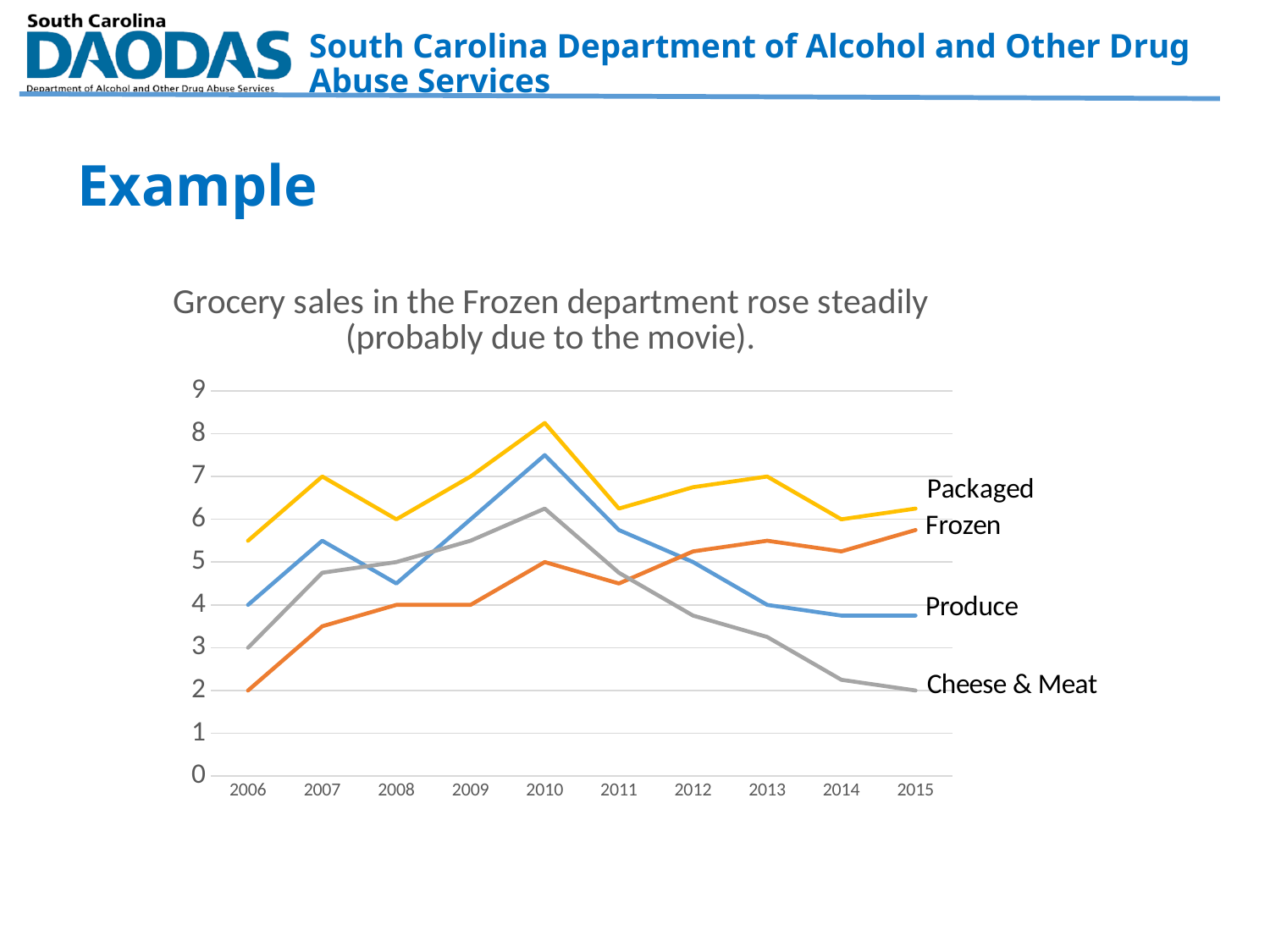
Is the value for Cheese & Meat in 2014 greater or less than 3? less What kind of chart is shown on the slide? line chart Which series has the lowest value in 2015? Cheese & Meat Which series is labelled with the orange line? Frozen In 2015, which is larger, the value for Packaged or the value for Produce? Packaged How many years are shown along the x axis? 10 How many series are plotted on the chart? 4 Does the Cheese & Meat line rise or fall from 2010 to 2015? fall Which series has the highest value in 2010? Packaged Which series has the lowest value in 2006? Frozen Is the value for Packaged in 2010 greater or less than 8? greater What is the title of the chart? Grocery sales in the Frozen department rose steadily (probably due to the movie).